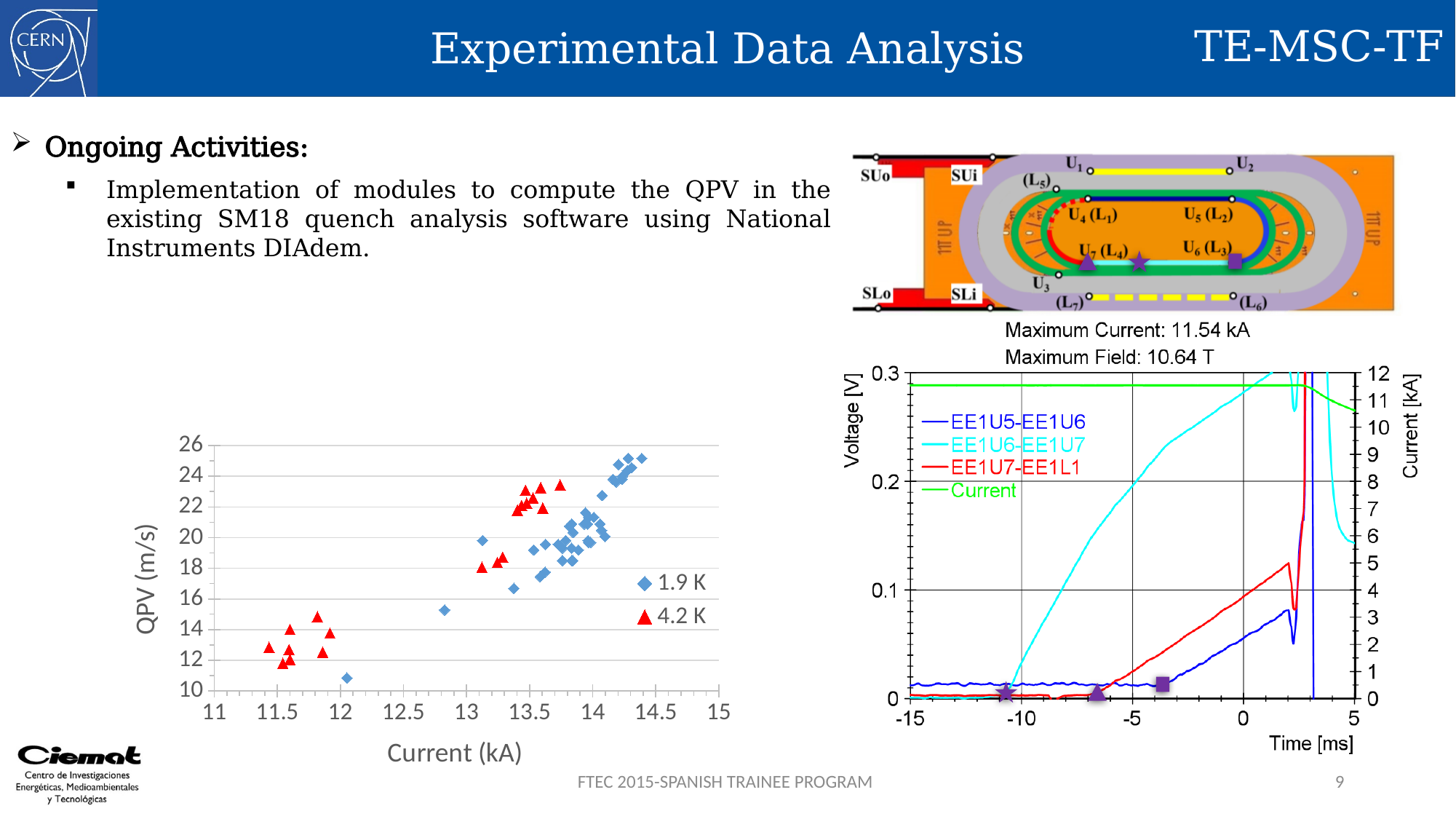
What are the two series named in the legend of the left QPV chart? 1.9 K and 4.2 K What kind of chart is the chart on the left with QPV (m/s) on the y axis? scatter chart In the left QPV chart, which series reaches the highest QPV values? 1.9 K In the left QPV chart, are the 1.9 K points near 14.3 kA greater or less than 22 m/s? greater What is the x-axis label of the right voltage-versus-time chart? Time [ms] In the left QPV chart, are the 4.2 K points near 11.5 kA greater or less than 16 m/s? less In the left QPV chart, do QPV values generally rise or fall as current increases? rise How many series does the legend of the right voltage-versus-time chart list? 4 How many series does the legend of the left QPV chart list? 2 In the right voltage-versus-time chart, is the EE1U7-EE1L1 voltage at -5 ms greater or less than 0.1 V? less In the right voltage-versus-time chart, which is larger at 0 ms: the EE1U6-EE1U7 voltage or the EE1U5-EE1U6 voltage? EE1U6-EE1U7